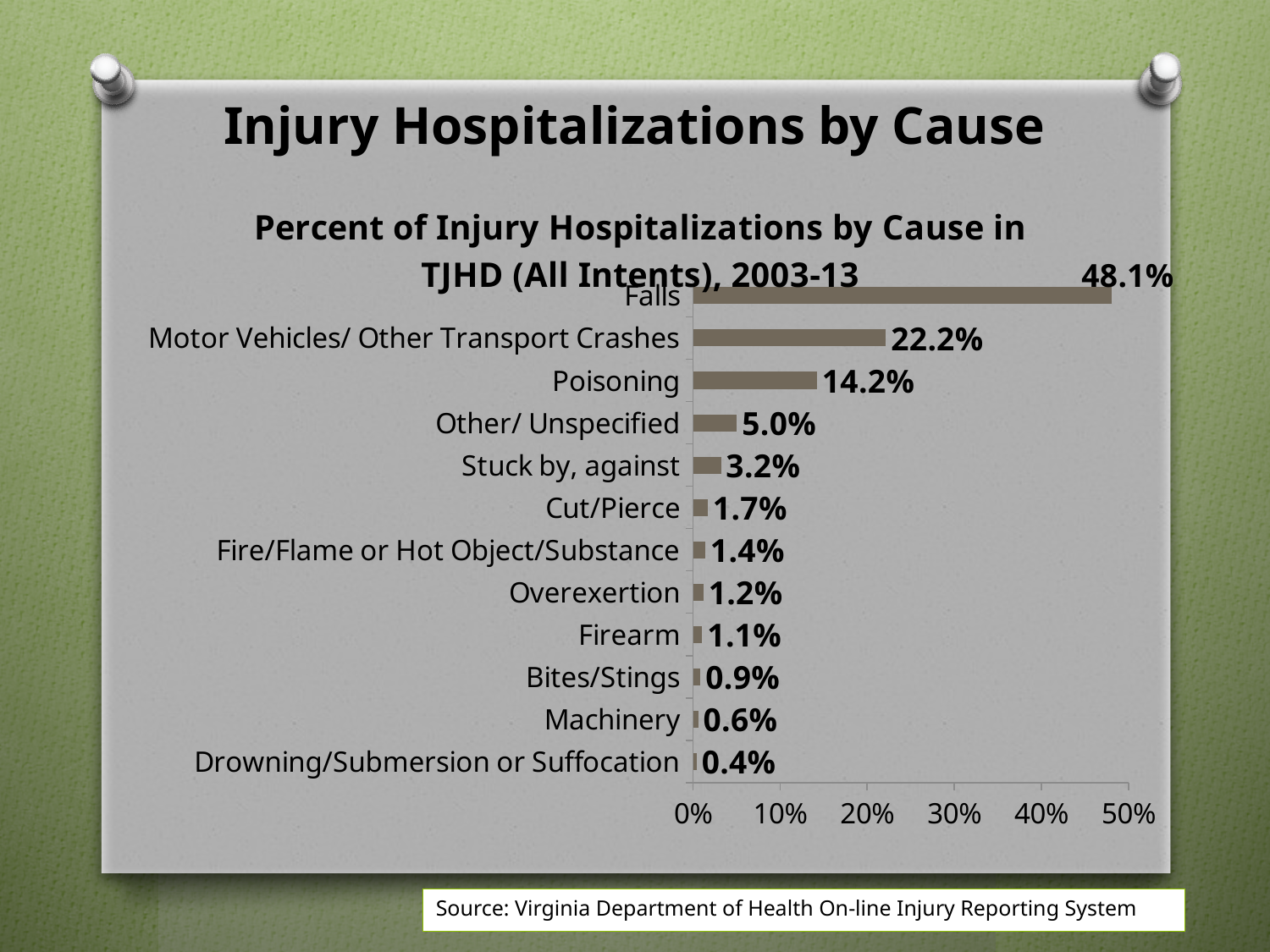
What is the value for Drowning/Submersion or Suffocation? 0.4% What is the title of the chart? Percent of Injury Hospitalizations by Cause in TJHD (All Intents), 2003-13 Which is larger, the value for Cut/Pierce or the value for Firearm? Cut/Pierce Which cause has the highest percent of injury hospitalizations? Falls What percent of injury hospitalizations is attributed to Falls? 48.1% Which cause has the lowest percent of injury hospitalizations? Drowning/Submersion or Suffocation What kind of chart is shown on the slide? Bar chart What is the value for Motor Vehicles/ Other Transport Crashes? 22.2% How many causes are shown in the chart? 12 Is the value for Falls greater or less than 40%? greater What is the value for Poisoning? 14.2% What is the difference between the values for Falls and Motor Vehicles/ Other Transport Crashes? 25.9%